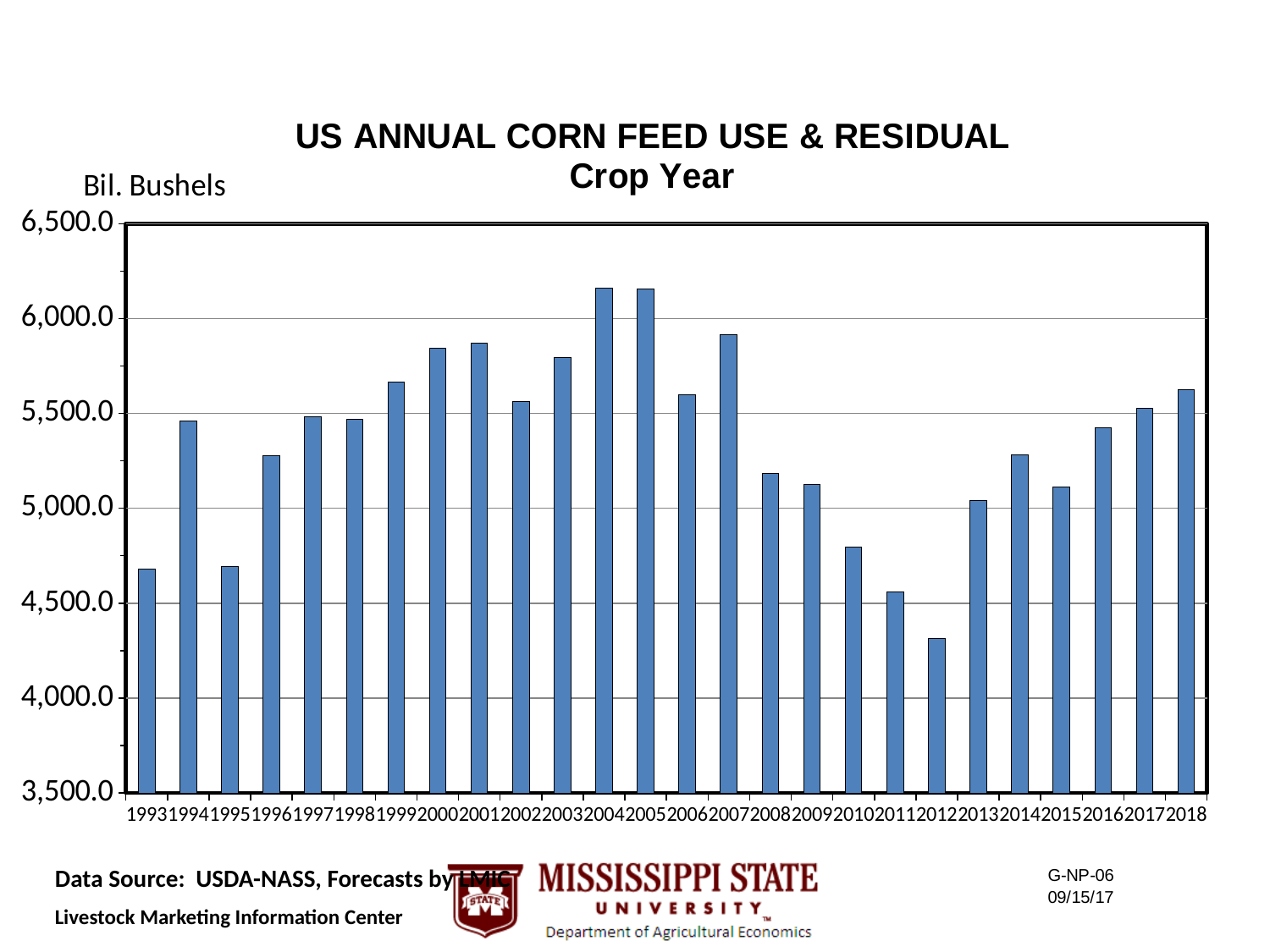
What unit is shown on the y axis of the chart? Bil. Bushels Is the value for 2010 greater or less than 5,000? less What kind of chart is shown on the slide? bar chart How many crop years are plotted on the chart? 26 Do the values rise or fall from 2008 to 2012? fall Is the value for 2000 greater or less than 5,500? greater Which is larger, the value for 2007 or the value for 2008? 2007 Is the value for 2012 greater or less than 4,500? less Which crop year has the lowest corn feed use & residual? 2012 Which is larger, the value for 2012 or the value for 2013? 2013